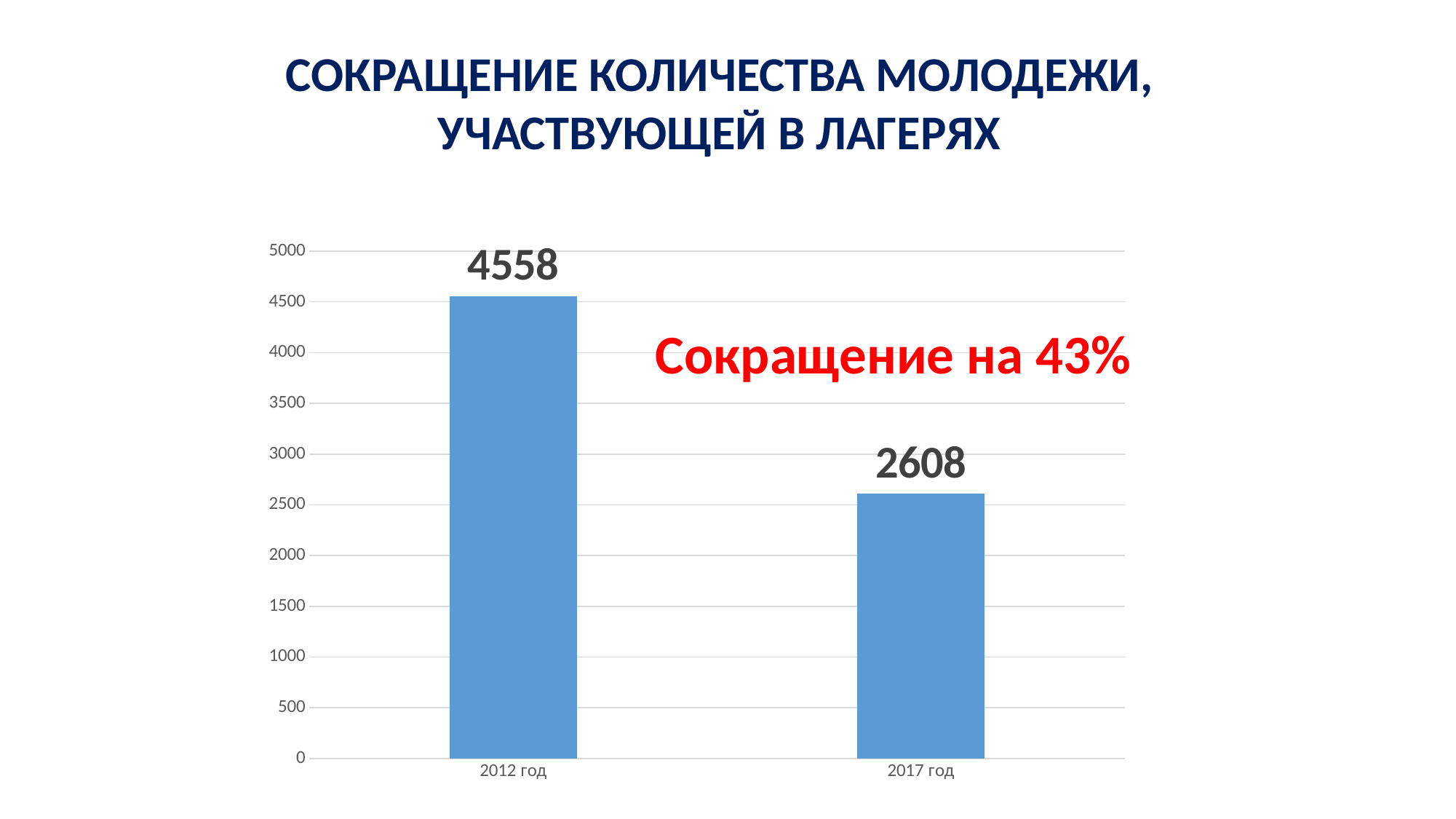
Do the values rise or fall from 2012 год to 2017 год? fall How many categories are shown on the x axis? 2 What kind of chart is shown on the slide? bar chart Which is larger, the value for 2012 год or the value for 2017 год? 2012 год What is the difference between the values for 2012 год and 2017 год? 1950 What is the value for 2017 год? 2608 Which category has the highest value? 2012 год Is the value for 2012 год greater or less than 4000? greater Which category has the lowest value? 2017 год What percentage reduction is stated in red text on the slide? 43% What is the value for 2012 год? 4558 Is the value for 2017 год greater or less than 3000? less